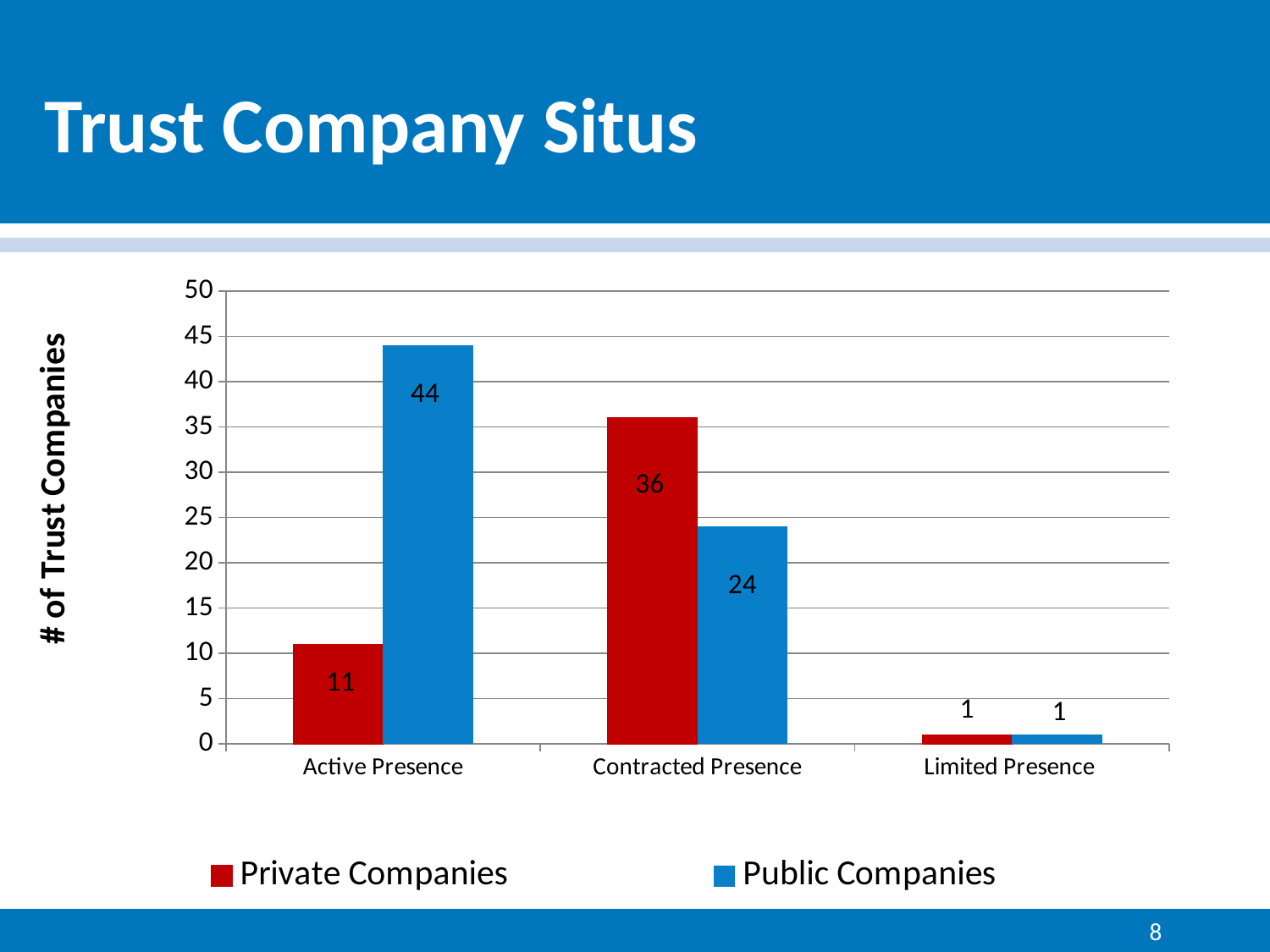
What is the difference between Public Companies and Private Companies under Active Presence? 33 Which category has the lowest value for Public Companies? Limited Presence What kind of chart is shown on the slide? Bar chart Under Contracted Presence, which is larger: Private Companies or Public Companies? Private Companies How many Public Companies have a Contracted Presence? 24 Which category has the highest value for Private Companies? Contracted Presence How many series does the legend list? 2 Is the value for Public Companies under Active Presence greater or less than 40? greater What is the value for Public Companies under Active Presence? 44 How many categories are shown on the x axis? 3 What is the label of the y axis? # of Trust Companies How many Private Companies have an Active Presence? 11